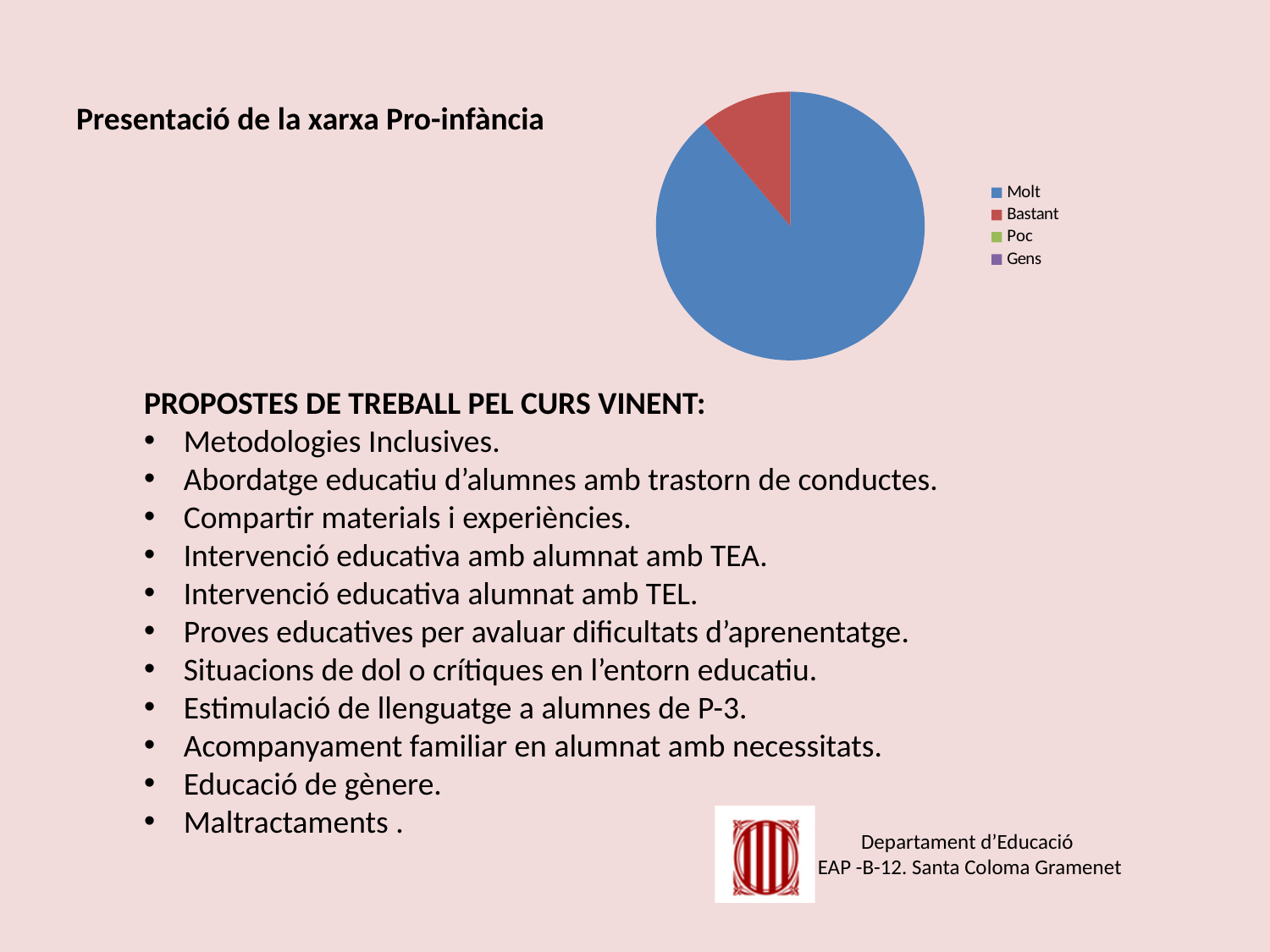
Which category has the largest slice in the pie chart? Molt Which is larger in the pie chart, Molt or Bastant? Molt Does the Molt slice take up more or less than half of the pie chart? more Which legend entry is listed first in the pie chart's legend? Molt What kind of chart is shown on the slide? pie chart Which colour represents Bastant in the pie chart? red Does the Bastant slice take up more or less than a quarter of the pie chart? less How many categories does the legend of the pie chart list? 4 Which colour represents Molt in the pie chart? blue